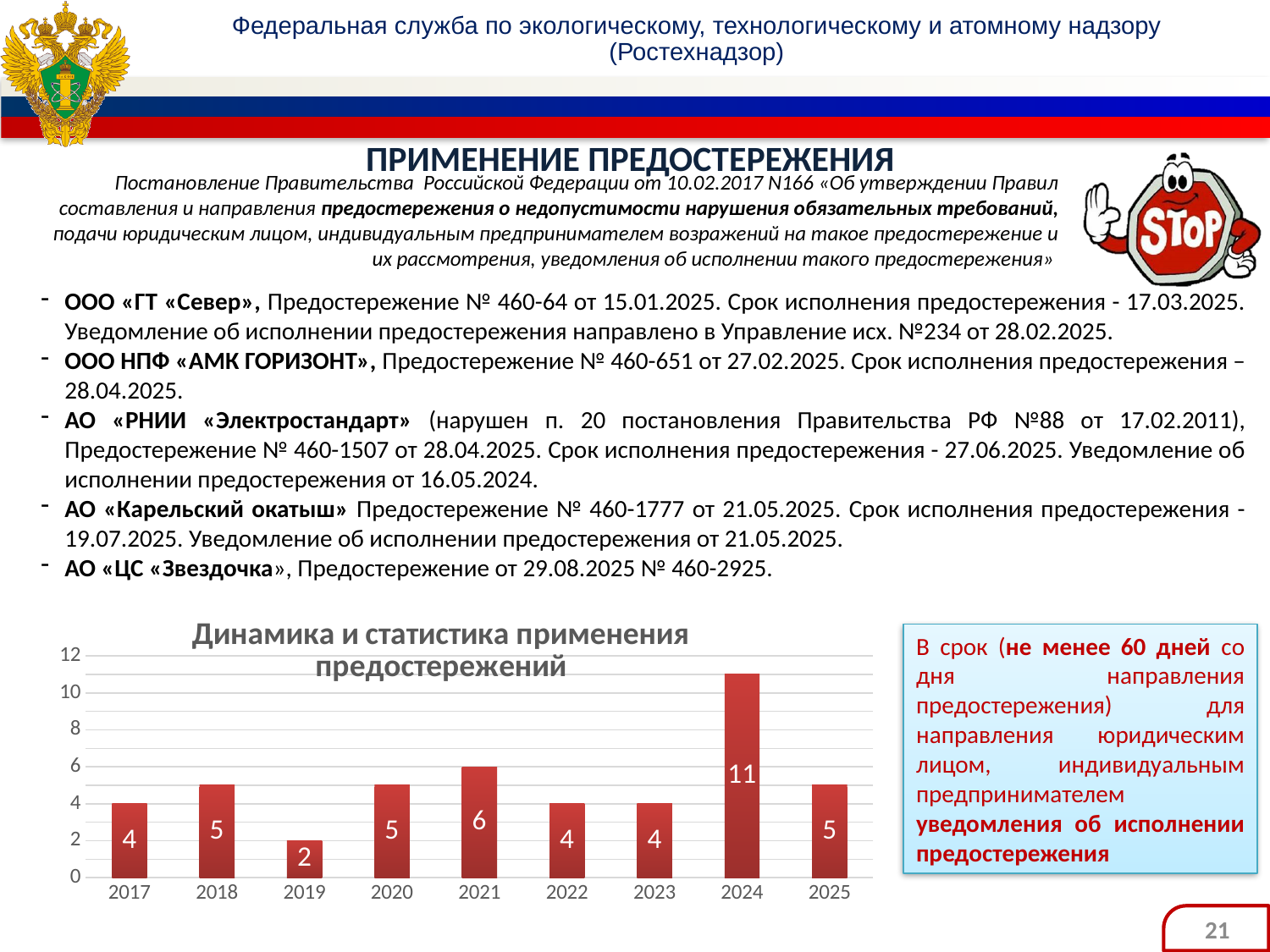
Is the value for 2024 greater or less than 10? greater What is the difference between the values for 2024 and 2023? 7 What is the value for 2024? 11 How many years are shown on the x axis? 9 Which year has the lowest value? 2019 What is the value for 2021? 6 Do the values rise or fall from 2024 to 2025? fall What is the value for 2019? 2 What kind of chart is shown? bar chart What is the title of the chart? Динамика и статистика применения предостережений Which year has the highest value? 2024 Which is larger, the value for 2021 or the value for 2020? 2021